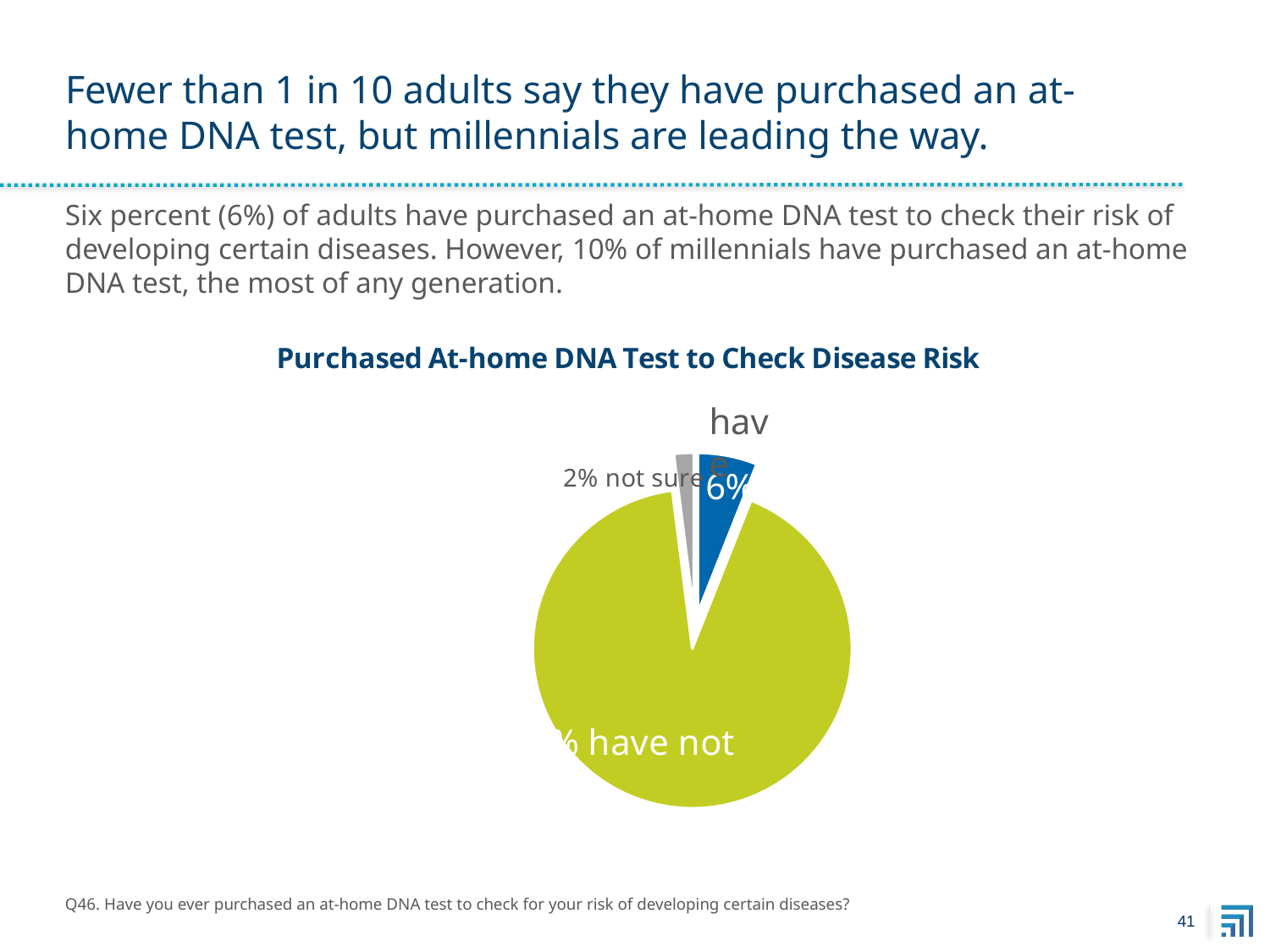
Which is larger: the share who have purchased a test or the share who are not sure? have purchased What is the title of the chart? Purchased At-home DNA Test to Check Disease Risk What type of chart is shown on the slide? pie chart What share of the pie does the 'have' slice represent? 6% What percentage of adults say they have purchased an at-home DNA test, according to the pie chart? 6% Which slice of the pie chart is the largest? have not What is the difference in percentage points between the 'have' slice and the 'not sure' slice? 4 percentage points How many slices does the pie chart have? 3 What percentage of adults are not sure whether they have purchased an at-home DNA test? 2% Which slice of the pie chart is the smallest? not sure What colour is the 'have not' slice of the pie chart? green